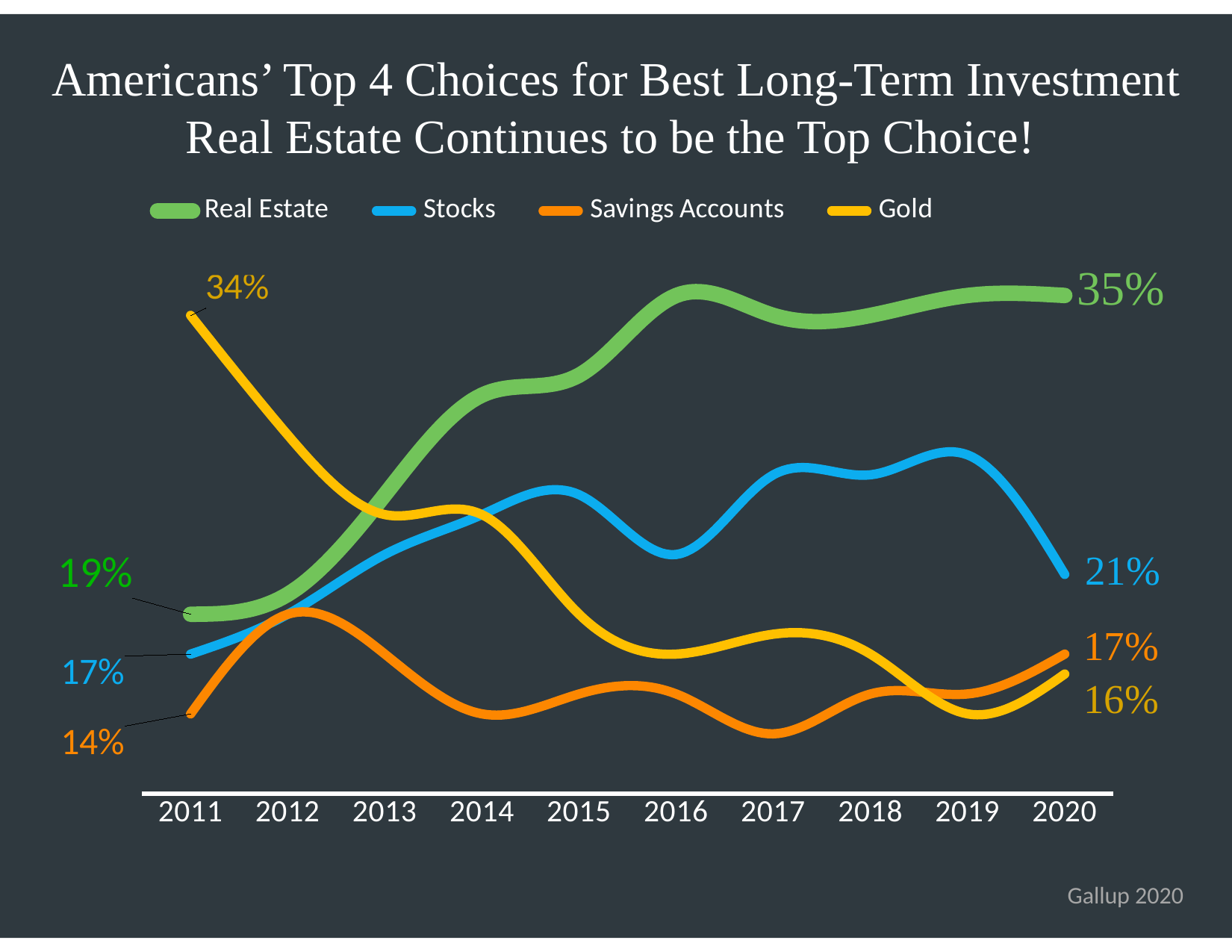
What was the value for Stocks in 2020? 21% What is the difference between the Real Estate value in 2020 and its value in 2011? 16% What was the value for Real Estate in 2020? 35% Which investment had the lowest value in 2020? Gold How many years are shown along the x axis? 10 In 2020, which is larger: the value for Stocks or the value for Savings Accounts? Stocks Which investment had the highest value in 2011? Gold What was the value for Gold in 2011? 34% Does the Gold line rise or fall from 2011 to 2020? fall What kind of chart is shown on the slide? line chart How many series does the legend list? 4 What was the value for Savings Accounts in 2011? 14%